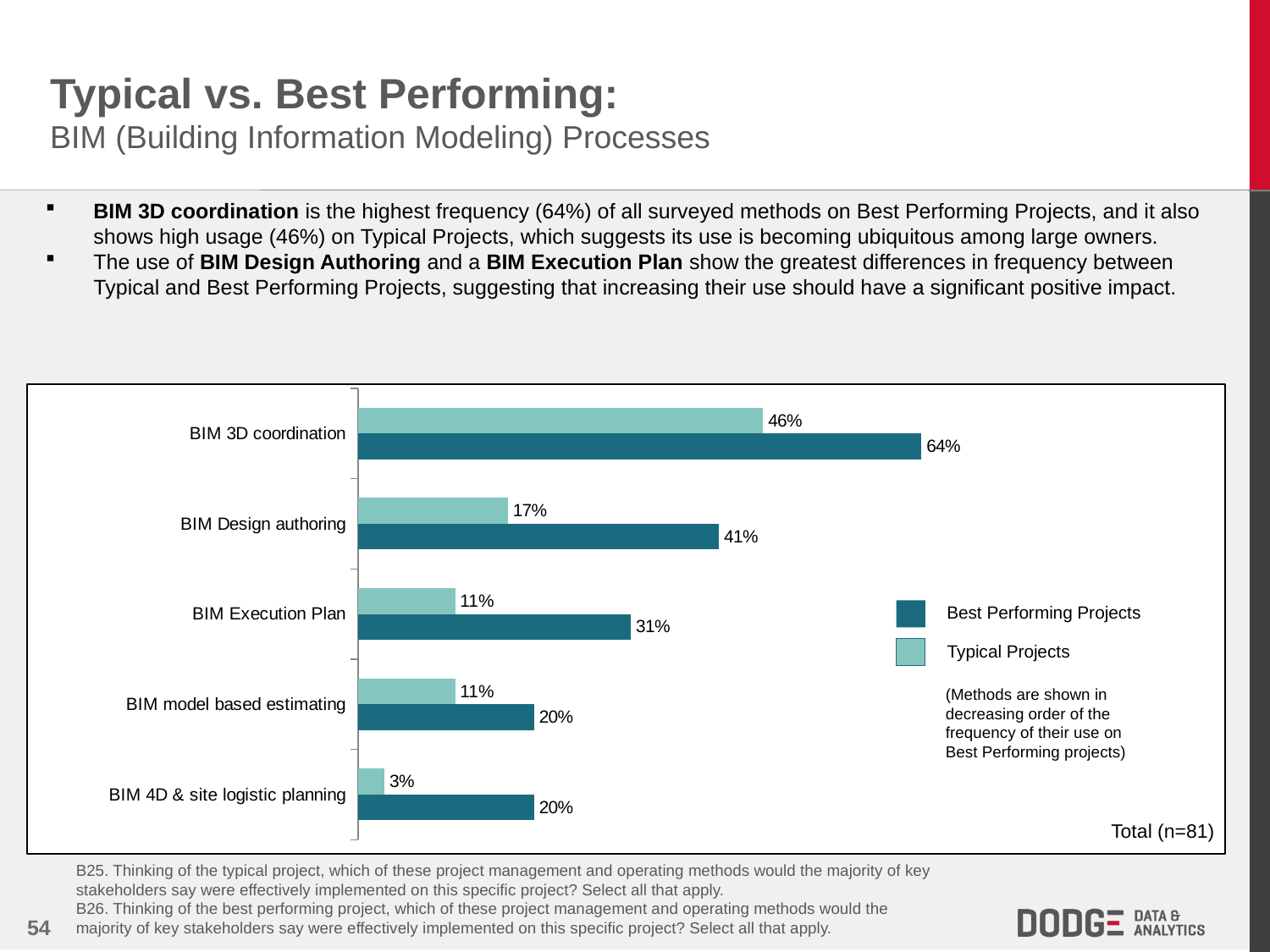
What is the total sample size shown on the chart? n=81 How many categories are shown in the chart? 5 What kind of chart is shown on the slide? Bar chart What is the value for Typical Projects for BIM Design authoring? 17% What is the value for Best Performing Projects for BIM 3D coordination? 64% How many series does the legend list? 2 Which category has the highest value for Best Performing Projects? BIM 3D coordination Which is larger for BIM model based estimating: Best Performing Projects or Typical Projects? Best Performing Projects What is the value for Typical Projects for BIM 4D & site logistic planning? 3% What is the difference between Best Performing Projects and Typical Projects for BIM Design authoring? 24% What is the difference between Best Performing Projects and Typical Projects for BIM Execution Plan? 20% Which category has the lowest value for Typical Projects? BIM 4D & site logistic planning